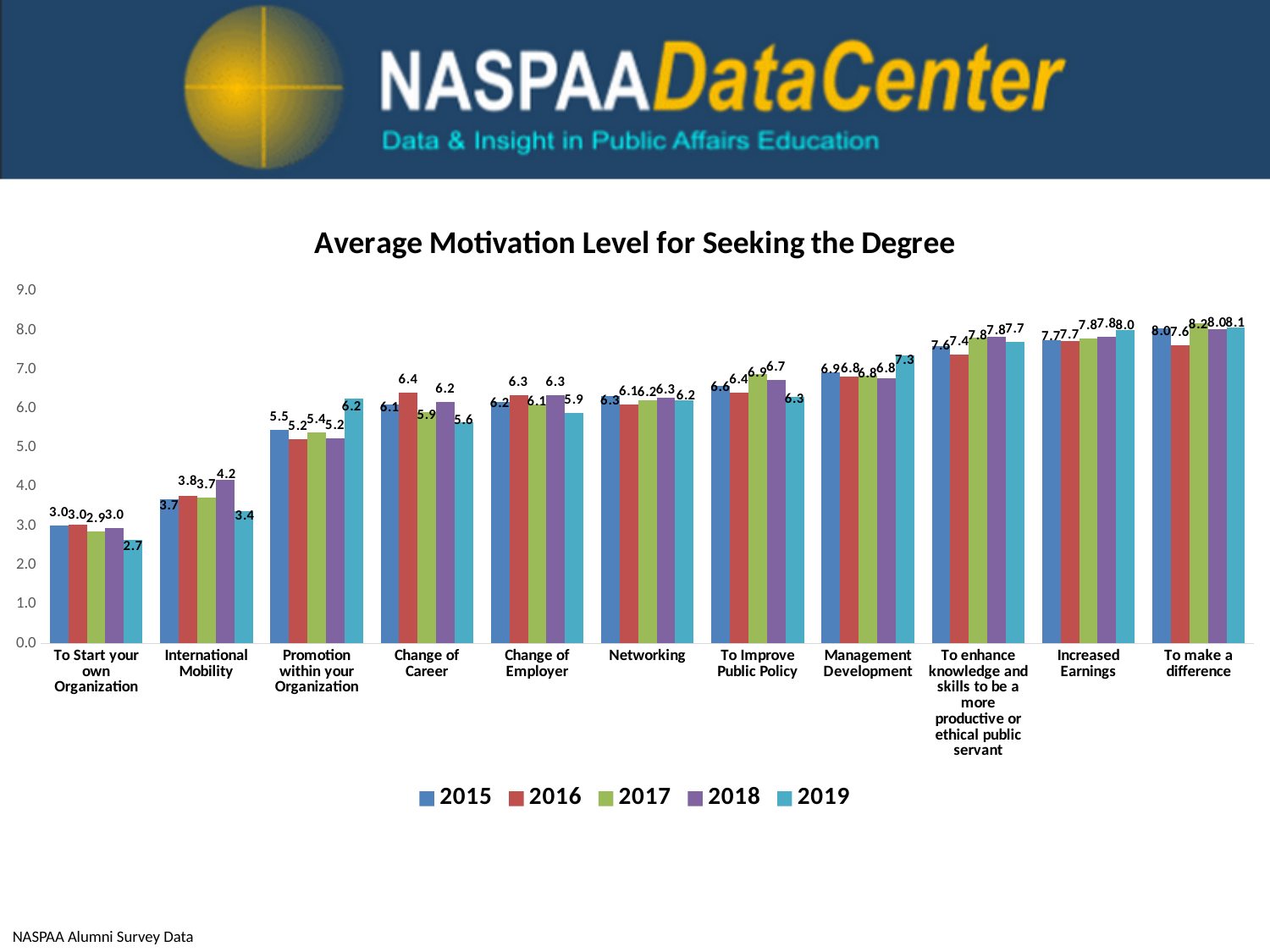
Which year has the highest value for To make a difference? 2017 What is the 2018 value for International Mobility? 4.2 How many series does the legend list? 5 What is the 2019 value for To Start your own Organization? 2.7 How many motivation categories are shown along the x axis? 11 What is the difference between the 2016 and 2019 values for Change of Career? 0.8 Which category has the lowest 2019 value? To Start your own Organization What is the title of the chart? Average Motivation Level for Seeking the Degree What is the 2019 value for Management Development? 7.3 What is the 2019 value for Promotion within your Organization? 6.2 Which is larger for Increased Earnings: the 2019 value or the 2016 value? 2019 What kind of chart is shown on the slide? bar chart